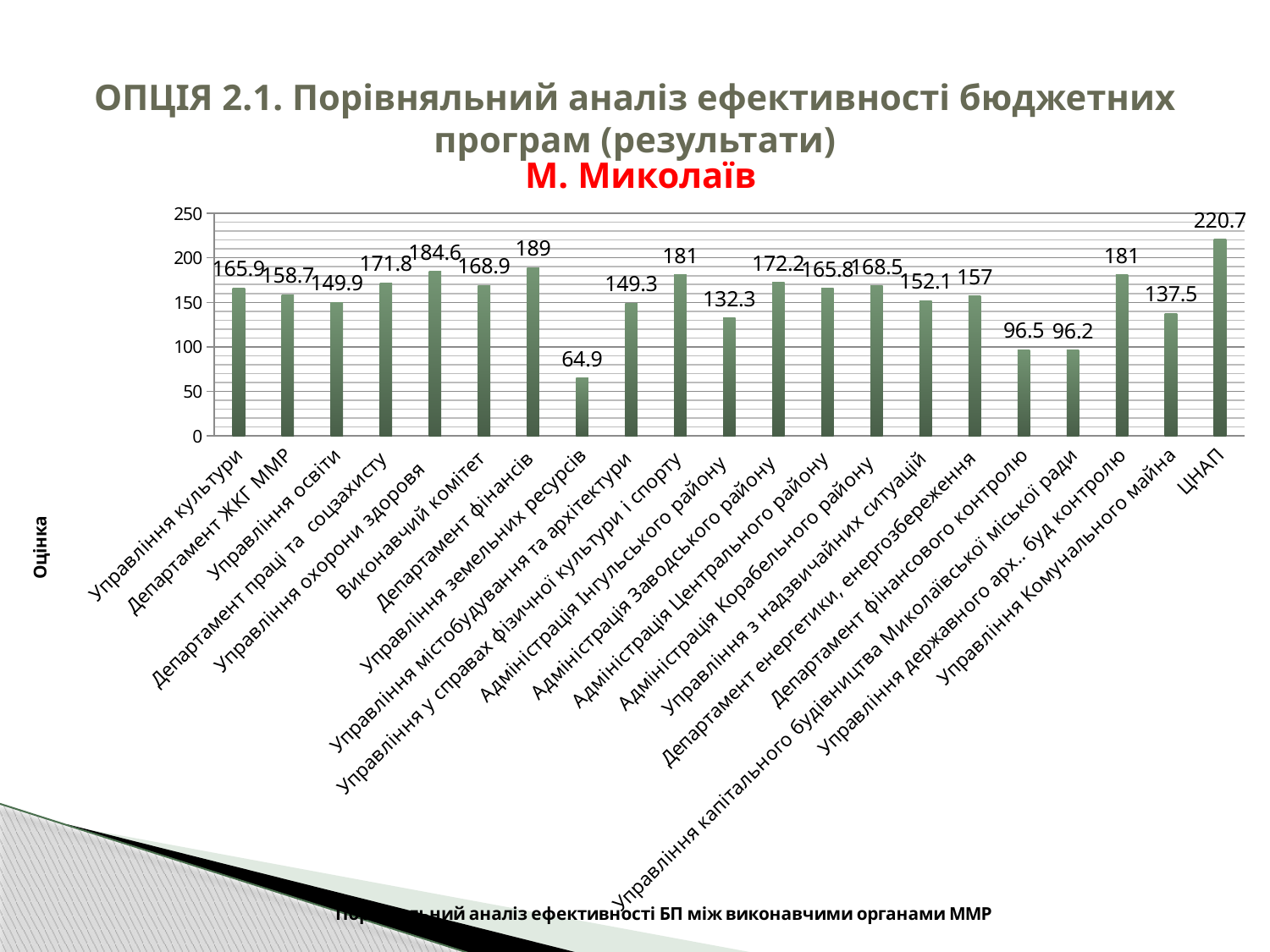
What kind of chart is shown on the slide? bar chart What is the value for Адміністрація Інгульського району? 132.3 What is the difference between the values for ЦНАП and Управління земельних ресурсів? 155.8 Which category has the lowest value? Управління земельних ресурсів What is the value for ЦНАП? 220.7 What is the value for Департамент фінансів? 189 Which category has the highest value? ЦНАП Which is larger: the value for Управління охорони здоровя or the value for Департамент праці та соцзахисту? Управління охорони здоровя How many categories are shown on the x axis? 21 What is the title of the chart? М. Миколаїв What is the value for Управління земельних ресурсів? 64.9 Is the value for Управління Комунального майна greater or less than 150? less